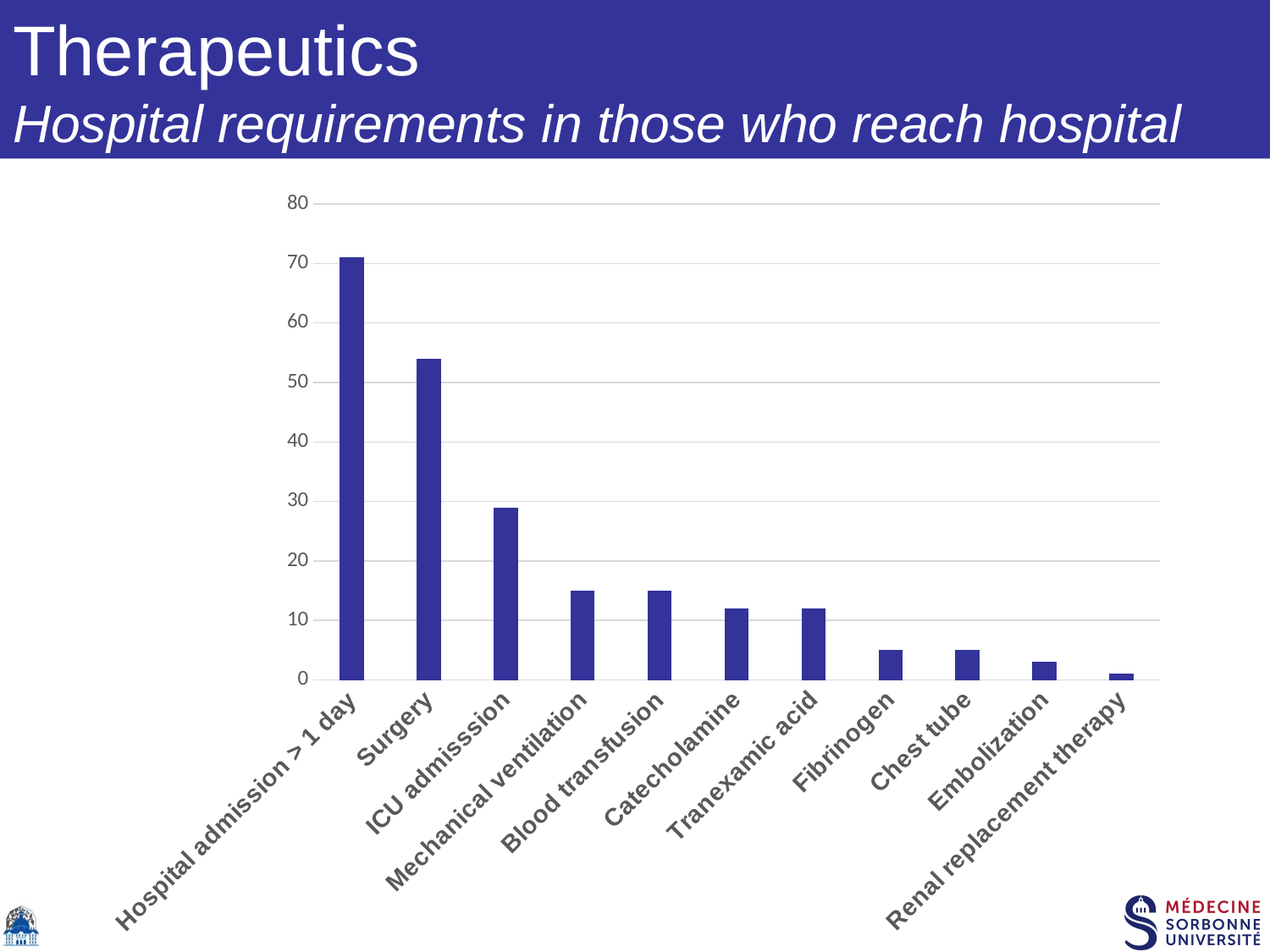
Is the value for Fibrinogen greater or less than 10? less Is the value for Hospital admission > 1 day greater or less than 60? greater How many categories are plotted on the chart? 11 What is the subtitle of the slide above the chart? Hospital requirements in those who reach hospital Which is larger, the value for Surgery or the value for ICU admisssion? Surgery Is the value for ICU admisssion greater or less than 20? greater Which category has the highest value? Hospital admission > 1 day Which category has the lowest value? Renal replacement therapy Do the values generally rise or fall from left to right along the x axis? fall What kind of chart is shown on the slide? bar chart